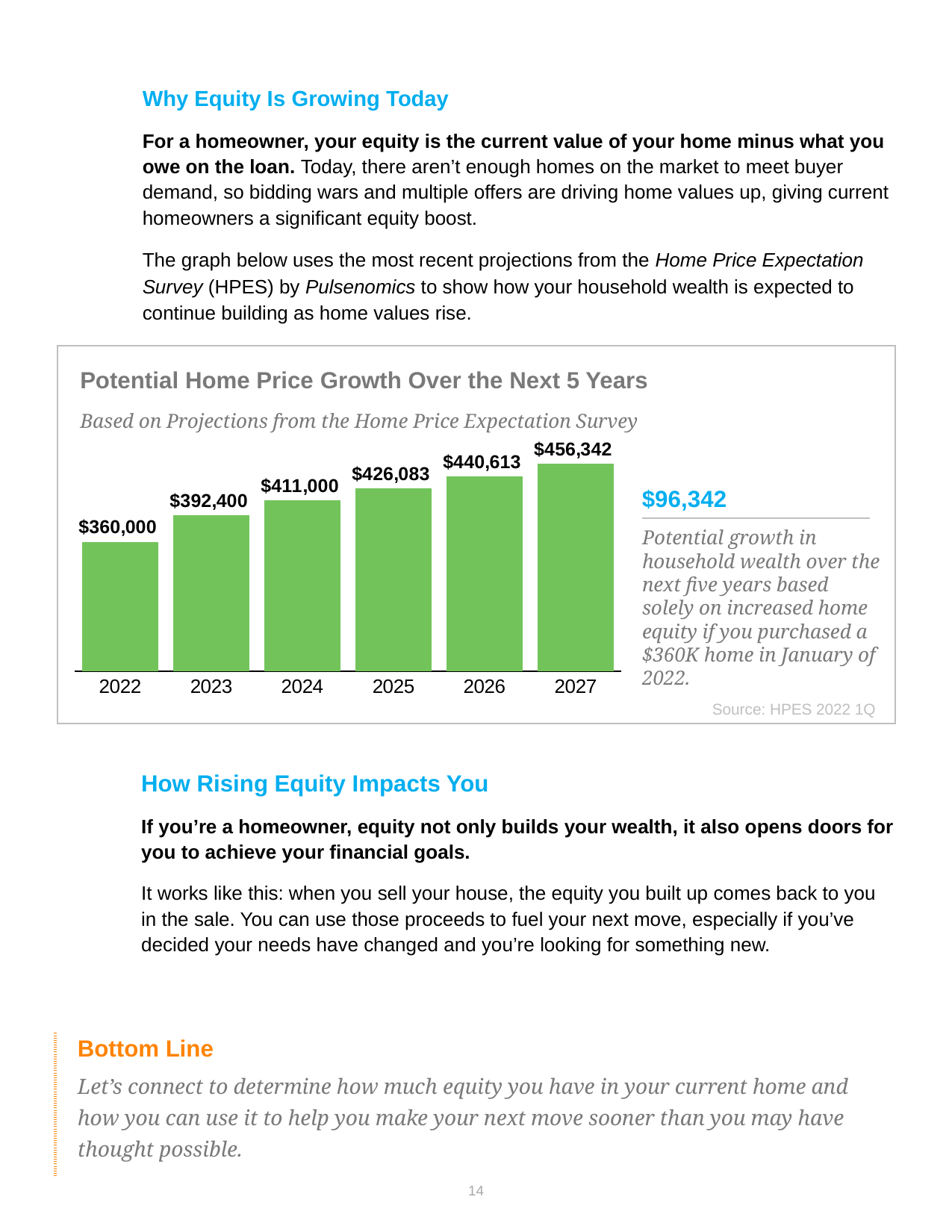
What is the difference between the projected home prices for 2023 and 2022? $32,400 Which is larger, the projected home price for 2025 or for 2026? 2026 What kind of chart is shown on the slide? Bar chart What is the projected home price for 2024? $411,000 What is the title of the chart? Potential Home Price Growth Over the Next 5 Years Which year has the lowest home price on the chart? 2022 How many years are shown on the chart? 6 What is the home price shown for 2022? $360,000 Which year has the highest projected home price? 2027 What is the difference between the projected home price in 2027 and the price in 2022? $96,342 What is the projected home price for 2027? $456,342 Do the projected home prices rise or fall from 2022 to 2027? Rise